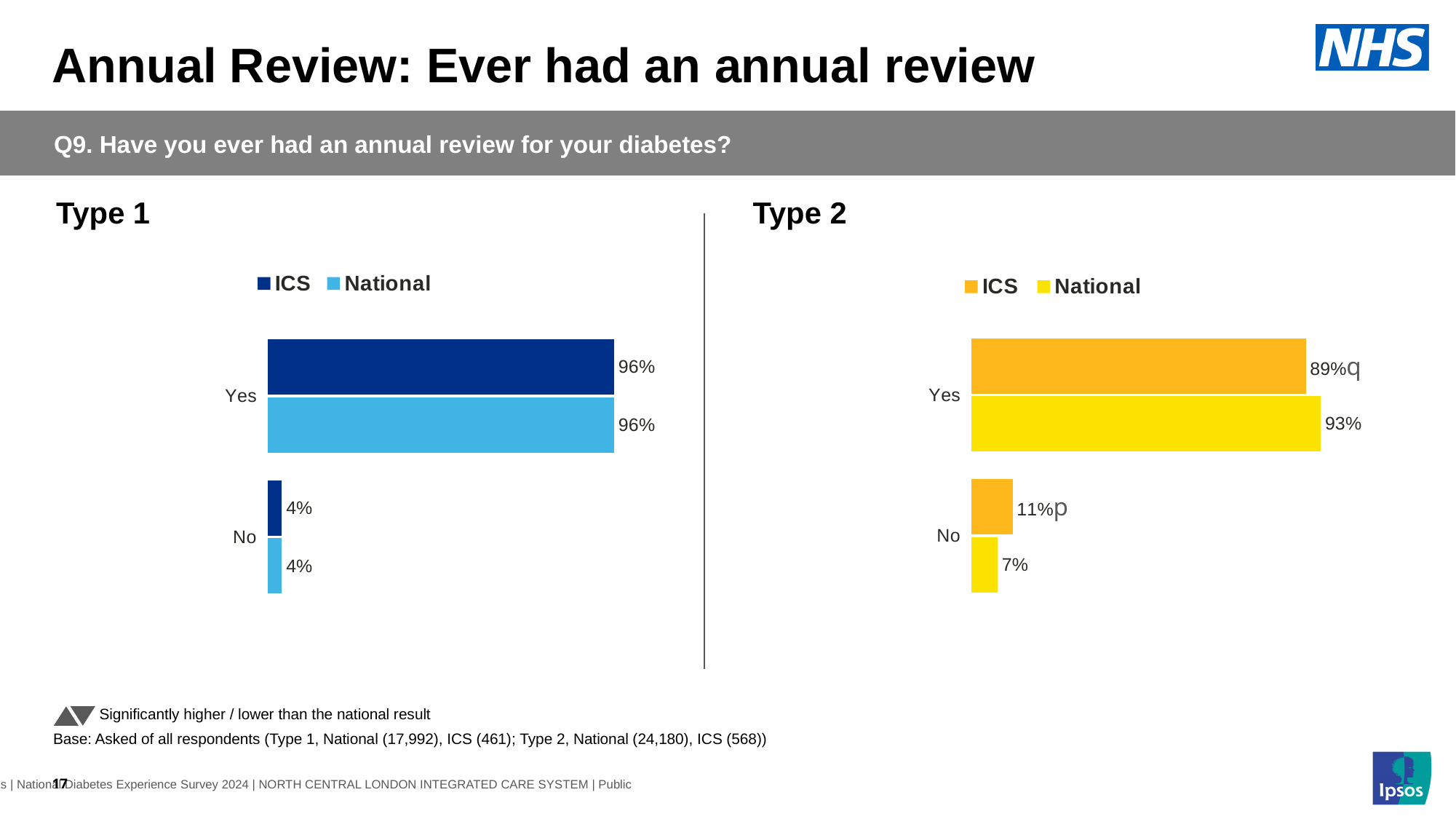
In the Type 1 chart, what is the ICS value for Yes? 96% In the Type 2 chart, what is the ICS value for No? 11% What kind of chart is the Type 1 chart? Bar chart In the Type 2 chart, what is the difference between the National and ICS values for Yes? 4% In the Type 2 chart, which series has the highest value for Yes? National In the Type 2 chart, what is the National value for Yes? 93% In the Type 1 chart, what is the National value for No? 4% In the Type 2 chart, what is the National value for No? 7% In the Type 2 chart, what is the ICS value for Yes? 89% How many series does the legend of the Type 1 chart list? 2 How many categories are shown in the Type 2 chart? 2 In the Type 2 chart, which is larger for No, the ICS value or the National value? ICS